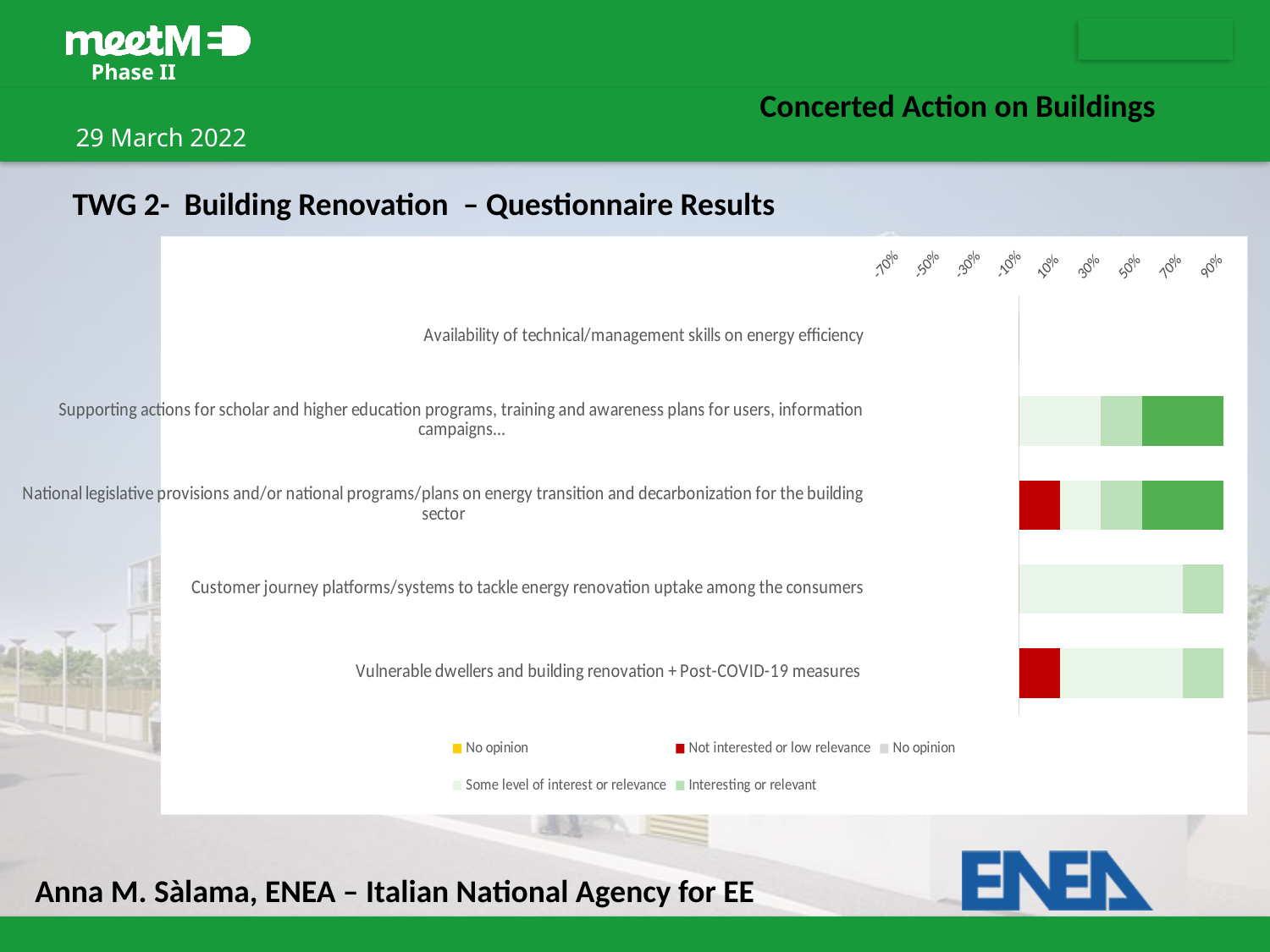
Which categories have a red 'Not interested or low relevance' segment extending to the left of zero? National legislative provisions and/or national programs/plans on energy transition and decarbonization for the building sector; Vulnerable dwellers and building renovation + Post-COVID-19 measures Which category shows no bar segments at all? Availability of technical/management skills on energy efficiency What kind of chart is shown on the slide? Stacked bar chart Which legend entry is shown in red? Not interested or low relevance Is the left-hand end of the red segment for 'Vulnerable dwellers and building renovation + Post-COVID-19 measures' greater or less than -50%? greater Is the right-hand end of the bar for 'Customer journey platforms/systems to tackle energy renovation uptake among the consumers' greater or less than 50%? greater What is the lowest value shown on the percentage axis? -70% How many categories (questionnaire topics) are listed on the chart? 5 How many entries does the chart legend list? 5